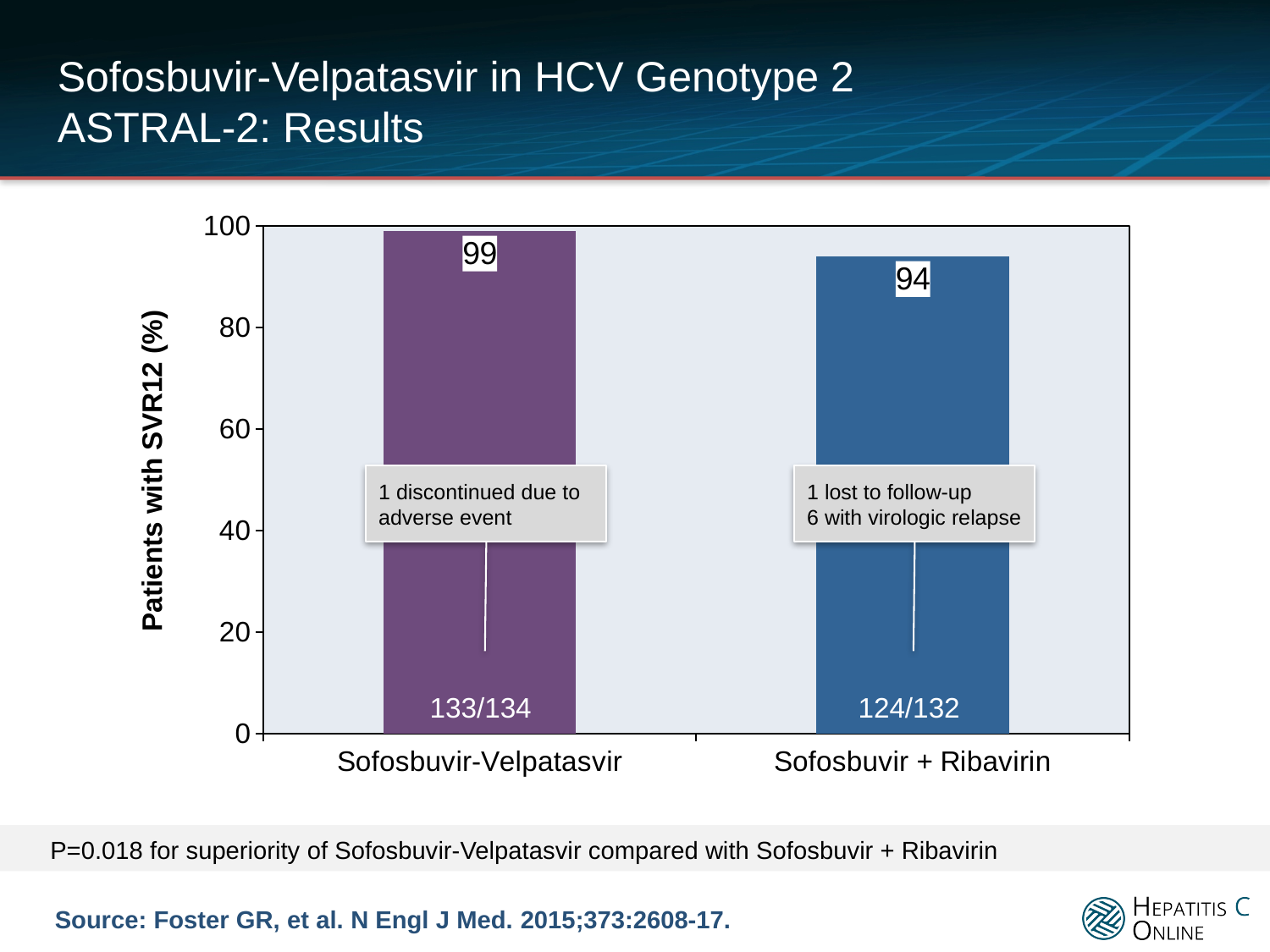
What fraction of patients achieved SVR12 in the Sofosbuvir-Velpatasvir arm? 133/134 What is the label of the y-axis? Patients with SVR12 (%) What kind of chart is shown on the slide? Bar chart What fraction of patients achieved SVR12 in the Sofosbuvir + Ribavirin arm? 124/132 What is the SVR12 rate for Sofosbuvir-Velpatasvir? 99 Which treatment arm has the highest SVR12 rate? Sofosbuvir-Velpatasvir Is the SVR12 rate for Sofosbuvir + Ribavirin greater or less than 80? greater Which treatment arm has the lowest SVR12 rate? Sofosbuvir + Ribavirin What is the difference in SVR12 rate between Sofosbuvir-Velpatasvir and Sofosbuvir + Ribavirin? 5 What is the SVR12 rate for Sofosbuvir + Ribavirin? 94 Which is larger, the SVR12 rate for Sofosbuvir-Velpatasvir or for Sofosbuvir + Ribavirin? Sofosbuvir-Velpatasvir How many treatment arms are shown in the chart? 2